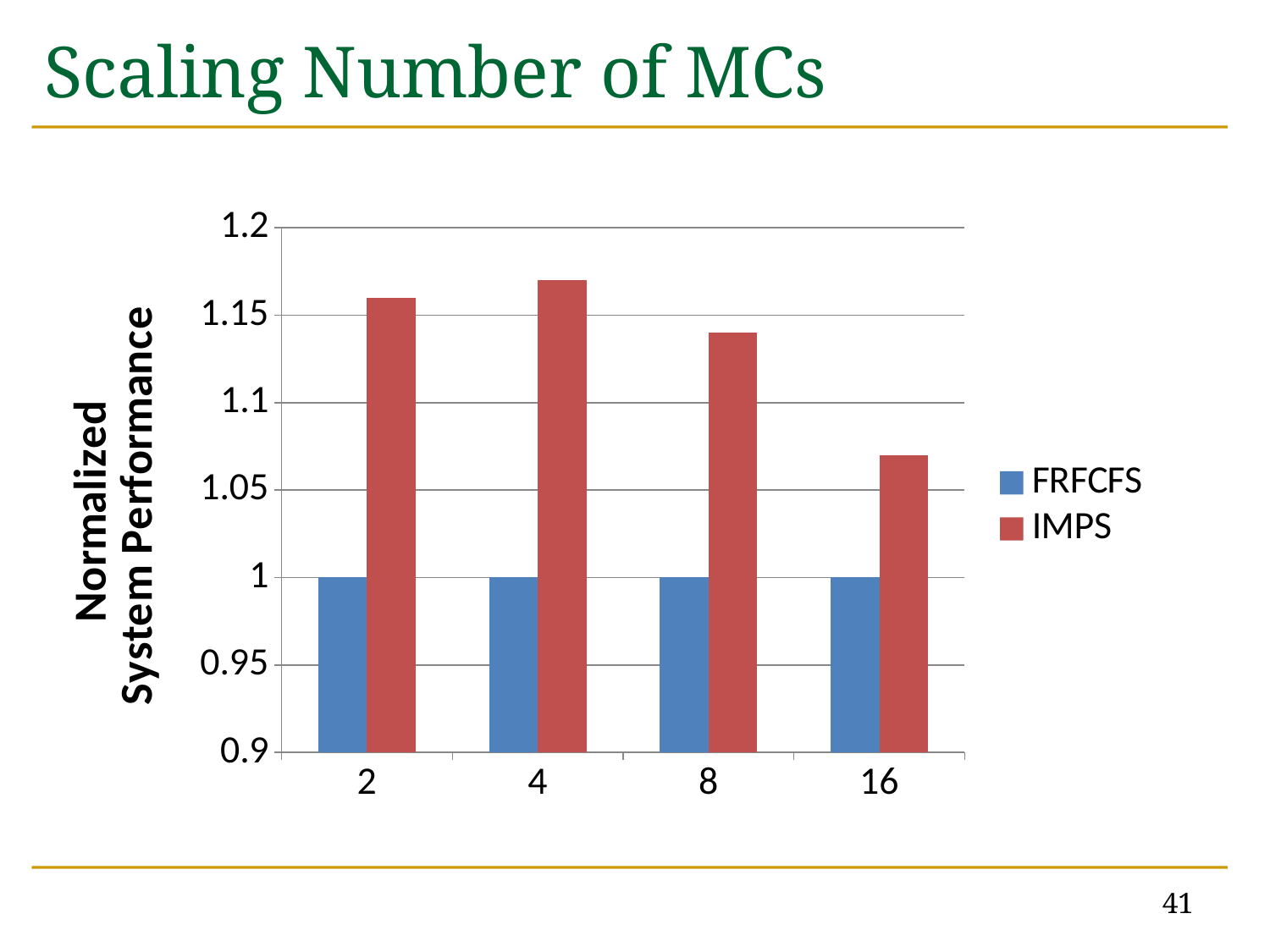
How many categories are shown on the x axis? 4 Which is larger at 16 MCs, the FRFCFS value or the IMPS value? IMPS What kind of chart is shown on the slide? bar chart How many series does the legend list? 2 What is the FRFCFS value for 16 MCs? 1 Does the IMPS value rise or fall from 8 MCs to 16 MCs? fall What is the label on the y axis? Normalized System Performance Is the IMPS value for 16 MCs greater or less than 1.1? less Is the IMPS value for 2 MCs greater or less than 1.1? greater What is the FRFCFS value for 8 MCs? 1 For which number of MCs is the IMPS value lowest? 16 Is the IMPS value for 4 MCs greater or less than 1.15? greater